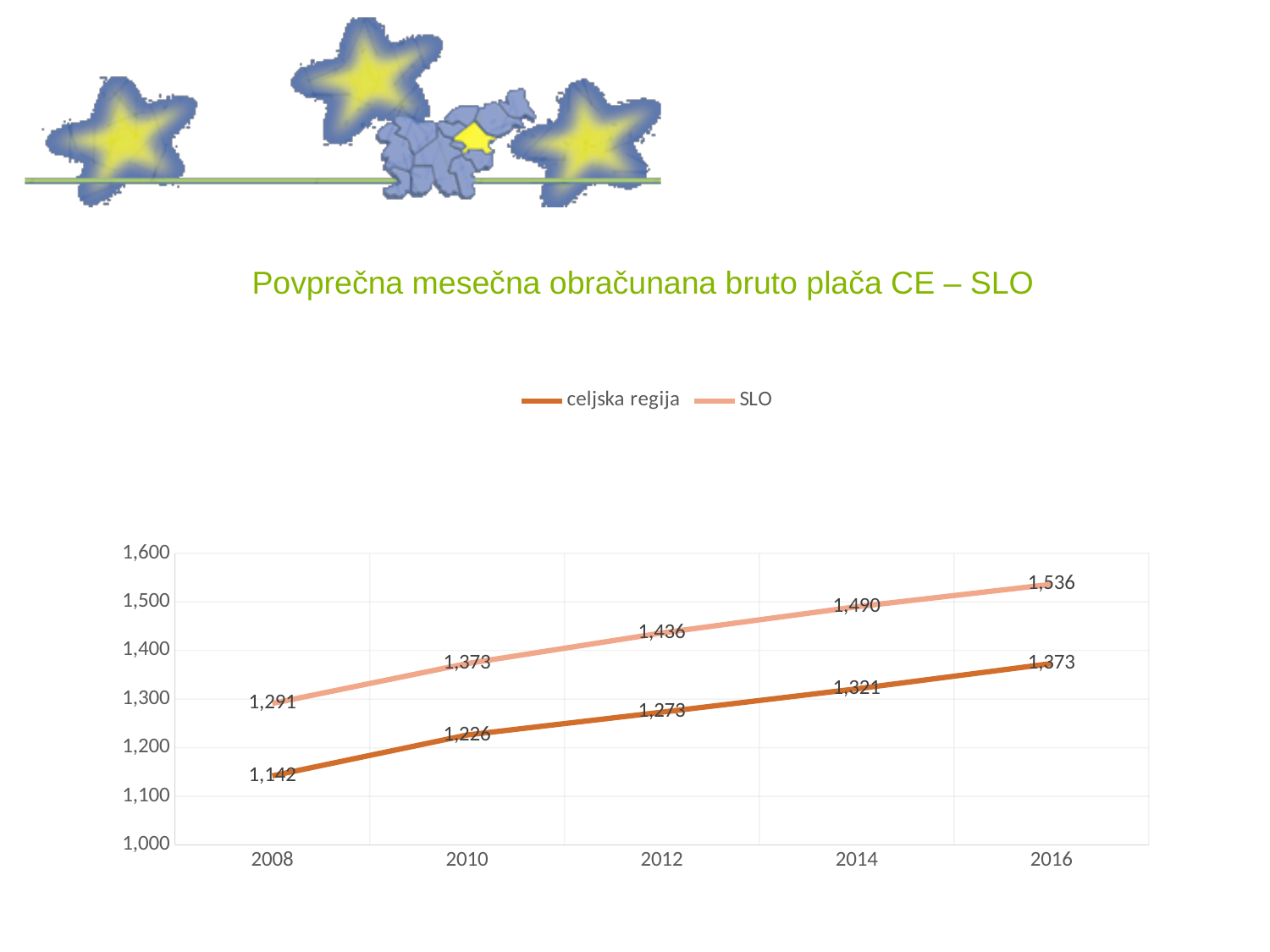
In which year is the value for celjska regija lowest? 2008 What is the value for SLO in 2016? 1,536 Which is larger in 2014, the value for SLO or for celjska regija? SLO What is the difference between SLO and celjska regija in 2016? 163 How many series does the legend list? 2 What is the value for celjska regija in 2012? 1,273 In which year is the value for SLO highest? 2016 How many years are shown on the x axis? 5 Do the values for celjska regija rise or fall from 2008 to 2016? rise What kind of chart is shown? line chart What is the value for SLO in 2010? 1,373 What is the value for celjska regija in 2008? 1,142